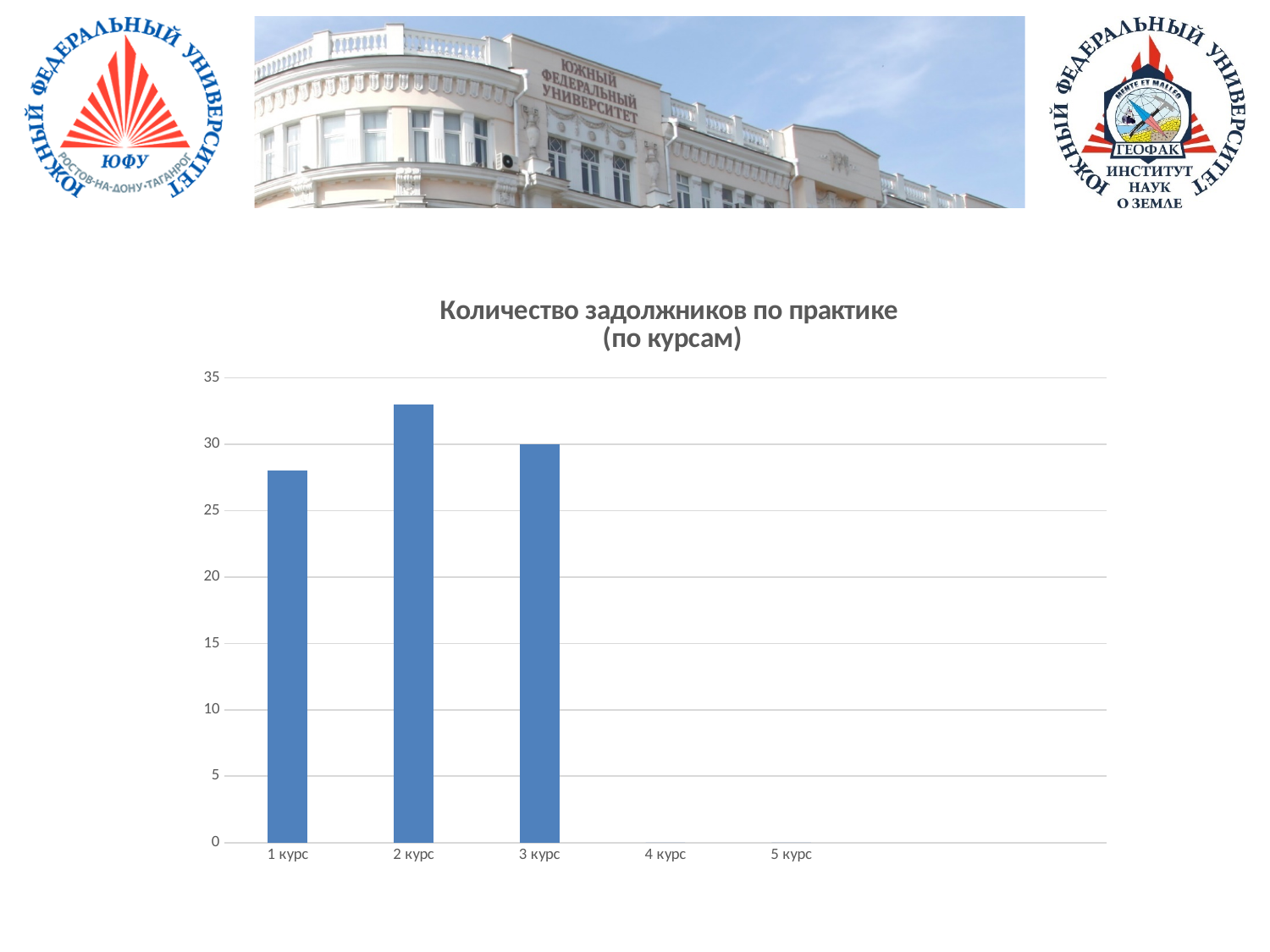
Is the value for 2 курс greater or less than 30? greater What kind of chart is shown on the slide? bar chart Is the value for 1 курс greater or less than 25? greater Is the value for 1 курс greater or less than 30? less Do the values rise or fall from 2 курс to 3 курс? fall What is the value for 3 курс? 30 Which is larger, the value for 2 курс or the value for 3 курс? 2 курс Which courses show no bar (zero debtors) in the chart? 4 курс and 5 курс Which course has the highest number of debtors in the chart? 2 курс What is the title of the chart? Количество задолжников по практике (по курсам) How many categories are shown on the x axis of the chart? 5